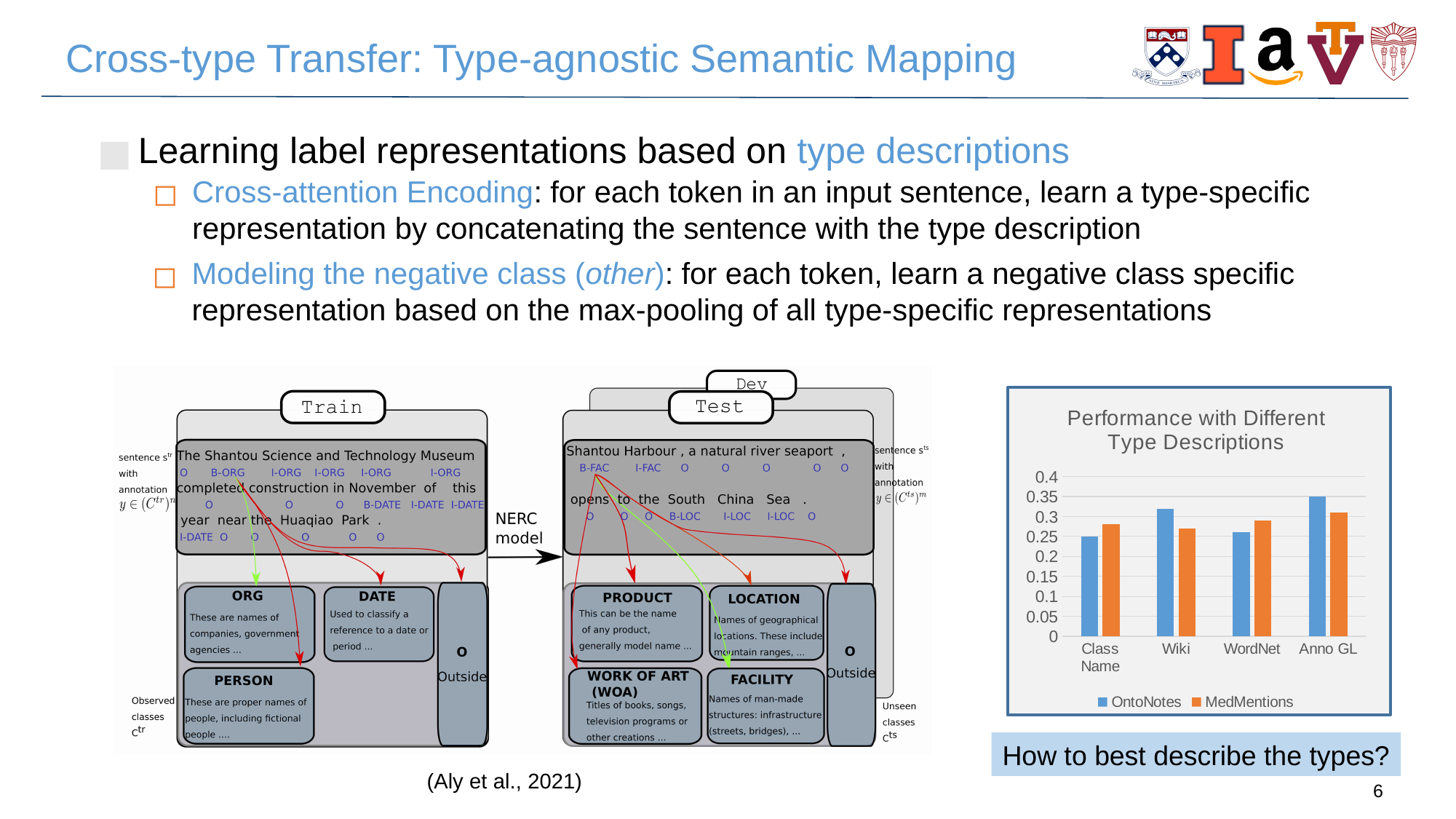
Is the OntoNotes value for Class Name greater or less than 0.3? less Is the OntoNotes value for Anno GL greater or less than 0.3? greater For Class Name, which series has the larger value, OntoNotes or MedMentions? MedMentions How many series does the chart's legend list? 2 For the OntoNotes series, which type description has the highest bar? Anno GL How many categories are shown on the x axis of the chart? 4 Which series is shown in orange in the chart? MedMentions For Wiki, which series has the larger value, OntoNotes or MedMentions? OntoNotes For the MedMentions series, which type description has the highest bar? Anno GL Is the MedMentions value for Wiki greater or less than 0.3? less What is the title of the chart on the slide? Performance with Different Type Descriptions What kind of chart is shown on the right side of the slide? bar chart